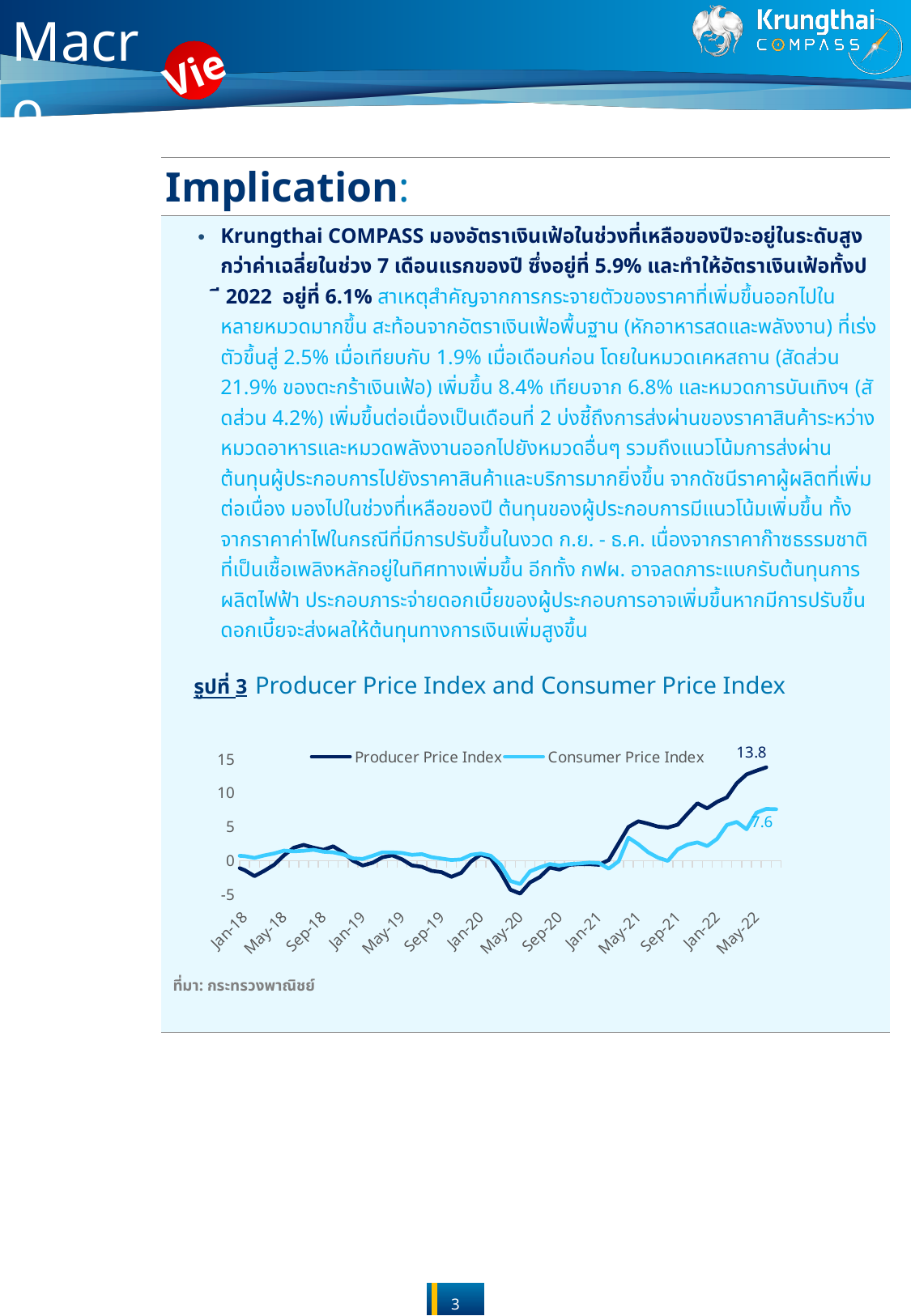
At the end of the series, which line is higher: Producer Price Index or Consumer Price Index? Producer Price Index What is the difference between the latest labelled values of the Producer Price Index (13.8) and the Consumer Price Index (7.6)? 6.2 What are the two series named in the chart legend? Producer Price Index and Consumer Price Index What is the latest labelled value of the Consumer Price Index line? 7.6 Is the Consumer Price Index value at the end of the series greater or less than 5? greater What is the first x-axis label shown on the chart? Jan-18 What is the latest labelled value of the Producer Price Index line? 13.8 From Jan-21 to the end of the series, does the Producer Price Index line generally rise or fall? rise Is the Producer Price Index value at the end of the series greater or less than 10? greater How many series does the legend of the chart list? 2 What kind of chart is shown under "Producer Price Index and Consumer Price Index"? line chart Is the Producer Price Index value around May-20 greater or less than 0? less